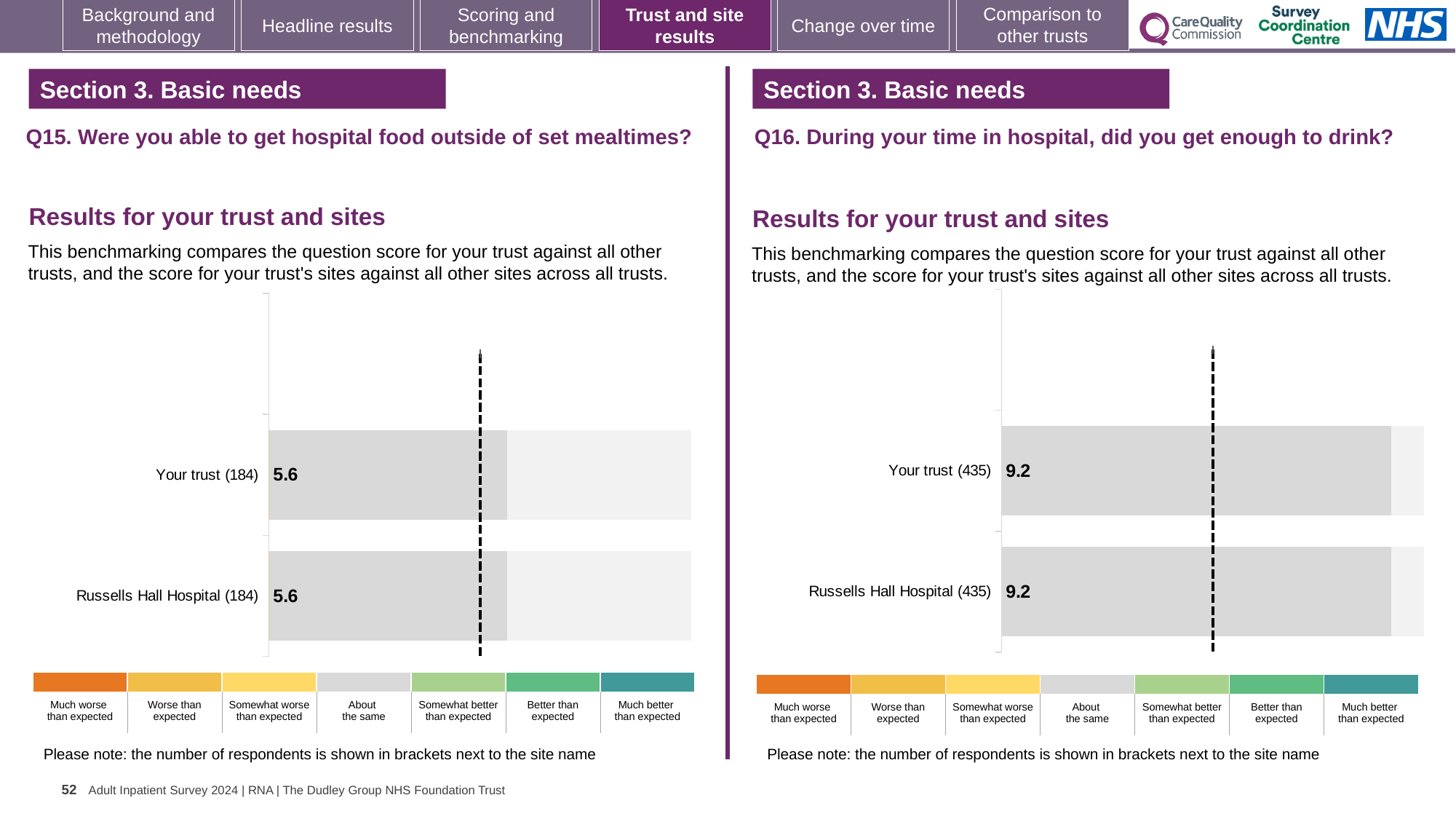
How many categories does the colour key below the Q15 chart (left) list? 7 On the Q15 chart (left), what is the score for Your trust? 5.6 How many bars are plotted on the Q16 chart (right)? 2 On the Q15 chart (left), how many respondents are shown in brackets next to Russells Hall Hospital? 184 On the Q15 chart (left), what is the difference between the score for Your trust and the score for Russells Hall Hospital? 0 On the Q16 chart (right), what is the score for Your trust? 9.2 What kind of chart is used on the Q16 chart (right)? Bar chart How many bars are plotted on the Q15 chart (left)? 2 On the Q16 chart (right), what is the difference between the score for Your trust and the score for Russells Hall Hospital? 0 On the Q16 chart (right), how many respondents are shown in brackets next to Your trust? 435 On the Q16 chart (right), what is the score for Russells Hall Hospital? 9.2 On the Q15 chart (left), what is the score for Russells Hall Hospital? 5.6